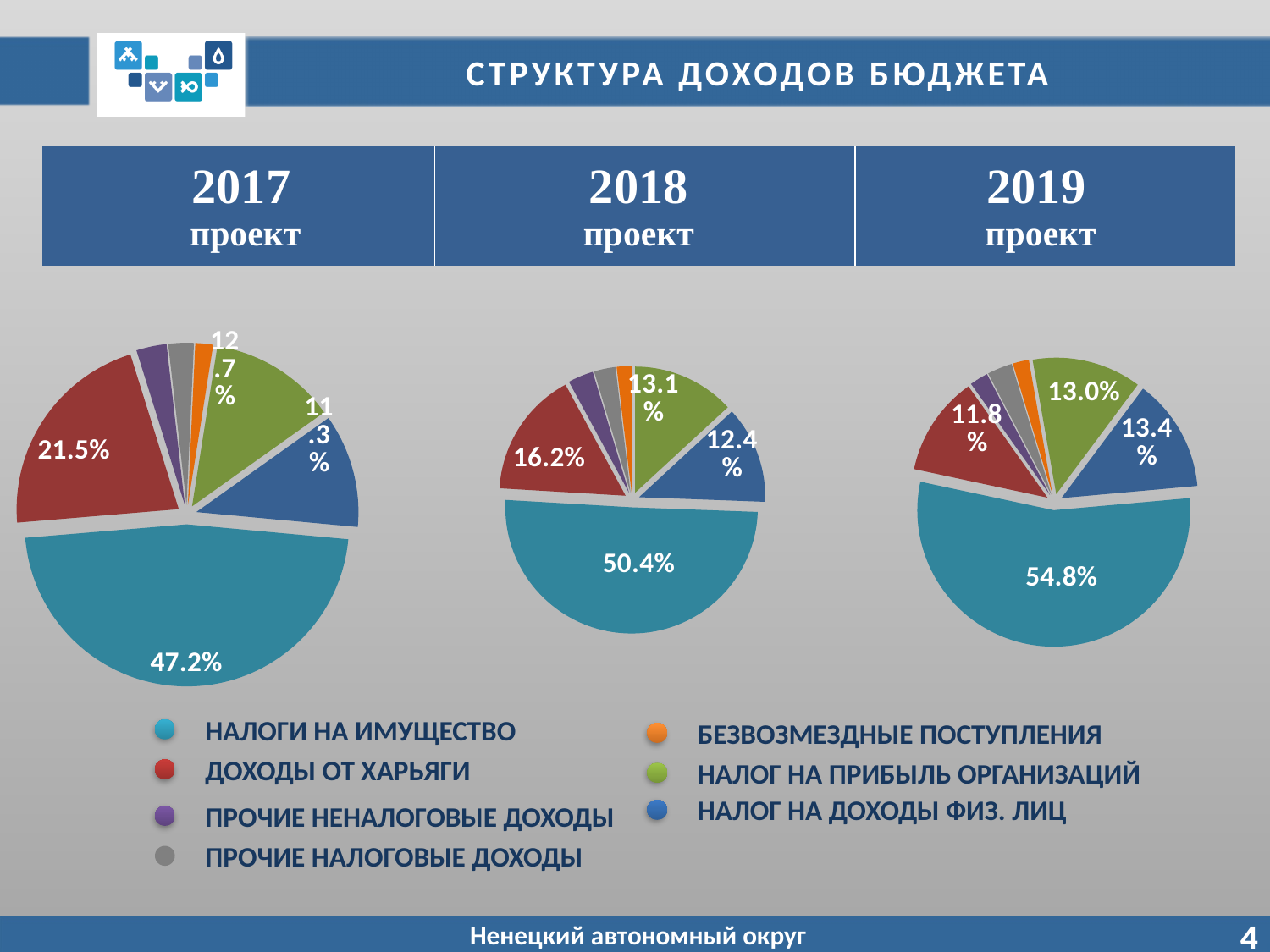
In the 2019 проект pie chart, what share is shown for Налог на прибыль организаций (the green slice)? 13.0% What type of chart is used for each of the three years on the slide? pie chart In the 2018 проект pie chart, what is the difference between the shares of Налоги на имущество and Доходы от Харьяги? 34.2% Which legend category is shown in orange on the pie charts? Безвозмездные поступления In the 2017 проект pie chart, what share is shown for Налоги на имущество (the teal slice)? 47.2% In the 2019 проект pie chart, what share is shown for Налог на доходы физ. лиц (the blue slice)? 13.4% Across the 2017, 2018 and 2019 проект pie charts, does the share of Налоги на имущество rise or fall over the years? rise In the 2017 проект pie chart, which is larger: the share of Доходы от Харьяги or the share of Налог на доходы физ. лиц? Доходы от Харьяги In the 2018 проект pie chart, what share is shown for Доходы от Харьяги (the red slice)? 16.2% How many categories does the shared legend list for the pie charts? 7 In the 2017 проект pie chart, which category has the largest share? Налоги на имущество Across the 2017, 2018 and 2019 проект pie charts, does the share of Доходы от Харьяги rise or fall over the years? fall